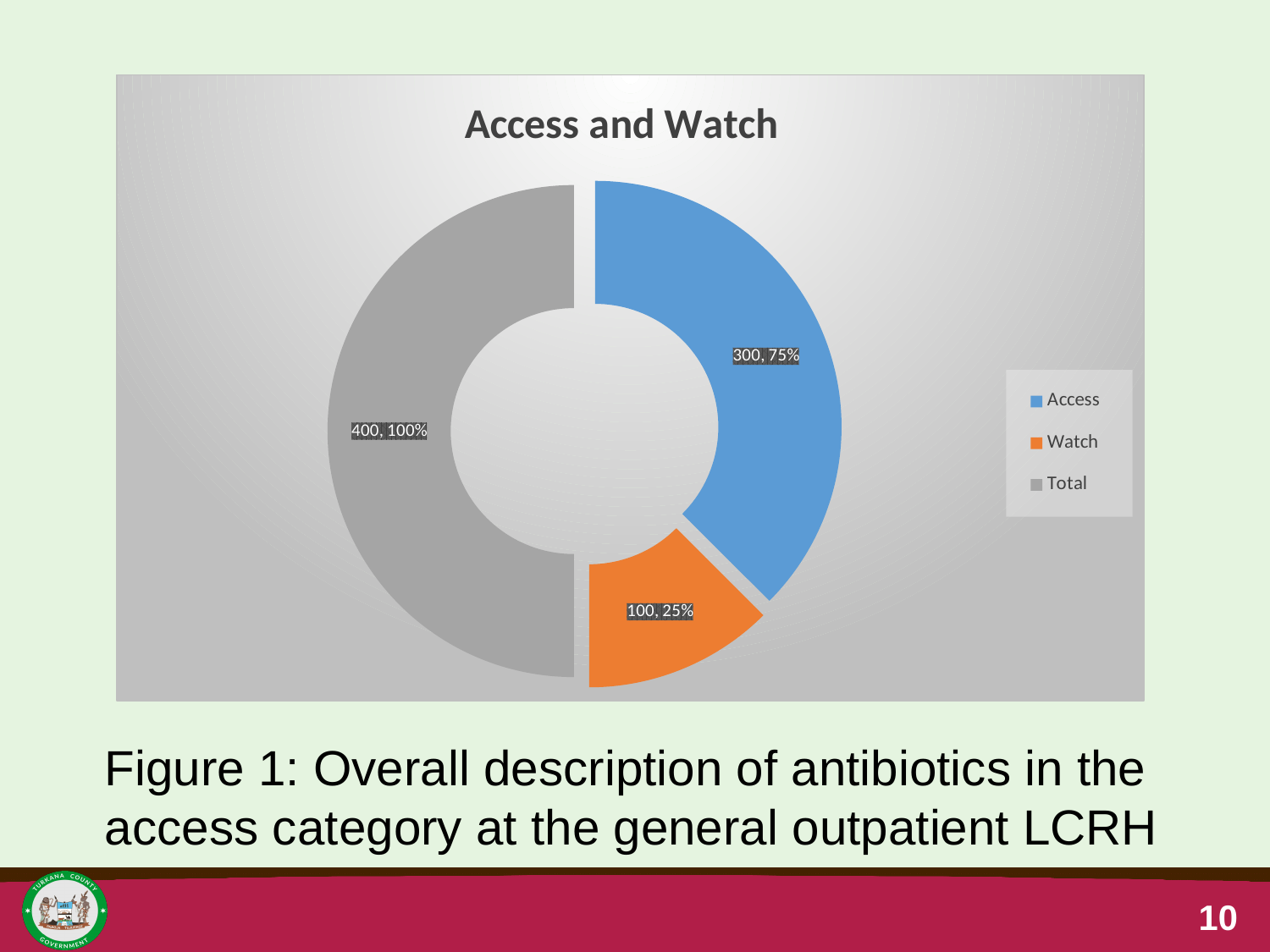
Which slice has the smallest value? Watch What value is labelled on the Total slice? 400 What value is labelled on the Watch slice? 100 What kind of chart is shown on the slide? doughnut chart What percentage is printed on the Watch slice? 25% Which slice has the largest value? Total What value is labelled on the Access slice? 300 Which is larger, the Access value or the Watch value? Access What is the difference between the Access value and the Watch value? 200 What percentage is printed on the Access slice? 75% What is the title of the chart? Access and Watch How many entries does the legend list? 3